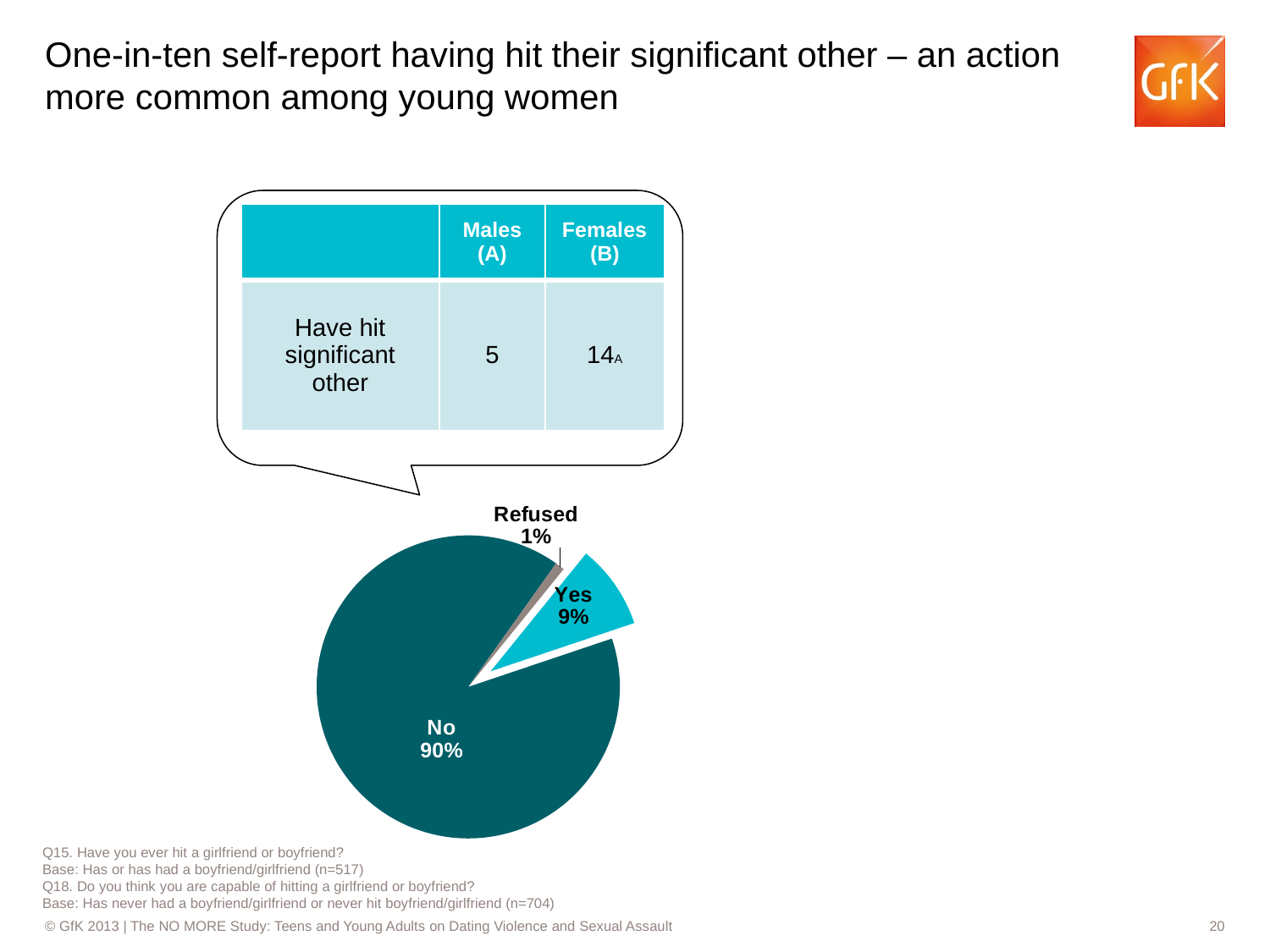
Which slice of the pie chart is the smallest? Refused What is the difference in percentage points between the "No" slice and the "Yes" slice? 81 What is the difference in percentage points between the "Yes" slice and the "Refused" slice? 8 What kind of chart is shown on the slide? pie chart What is the combined share of the "Yes" and "Refused" slices in the pie chart? 10% Which slice of the pie chart is the largest? No What share of the pie chart is labelled "Refused"? 1% What share of the pie chart is labelled "No"? 90% What share of the pie chart is labelled "Yes"? 9% How many slices does the pie chart have? 3 Which slice of the pie chart is pulled out (exploded) from the rest of the pie? Yes Which is larger in the pie chart, the "Yes" slice or the "Refused" slice? Yes